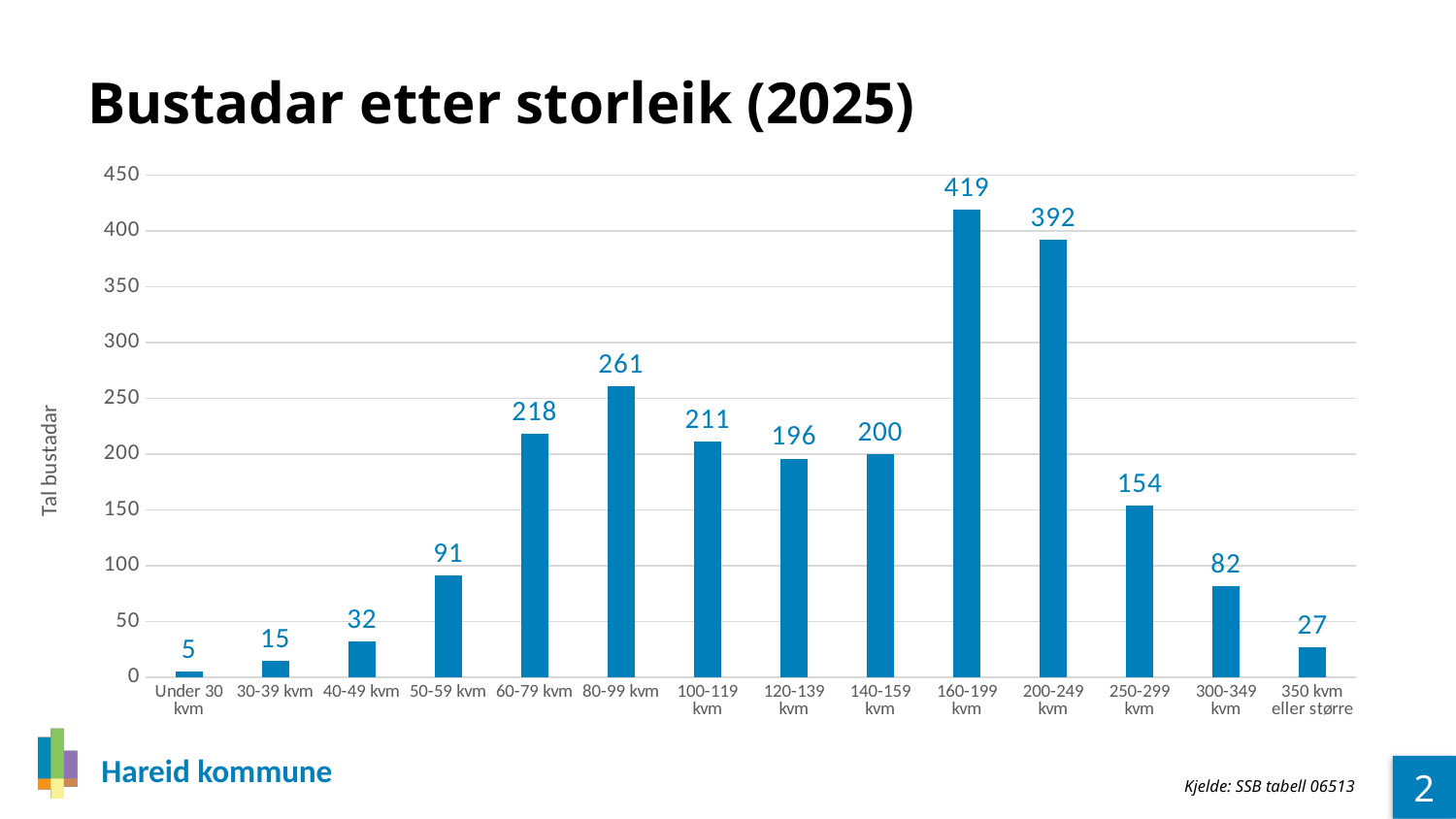
What is the difference between the values for 160-199 kvm and 200-249 kvm? 27 What kind of chart is this? bar chart Is the value for 250-299 kvm greater or less than 150? greater How many categories are shown on the x axis? 14 Which is larger, the value for 80-99 kvm or the value for 60-79 kvm? 80-99 kvm Which category has the highest value? 160-199 kvm What is the label on the y axis? Tal bustadar What is the value for 50-59 kvm? 91 What is the value for 350 kvm eller større? 27 Which category has the lowest value? Under 30 kvm What is the title of the chart? Bustadar etter storleik (2025) What is the value for 160-199 kvm? 419